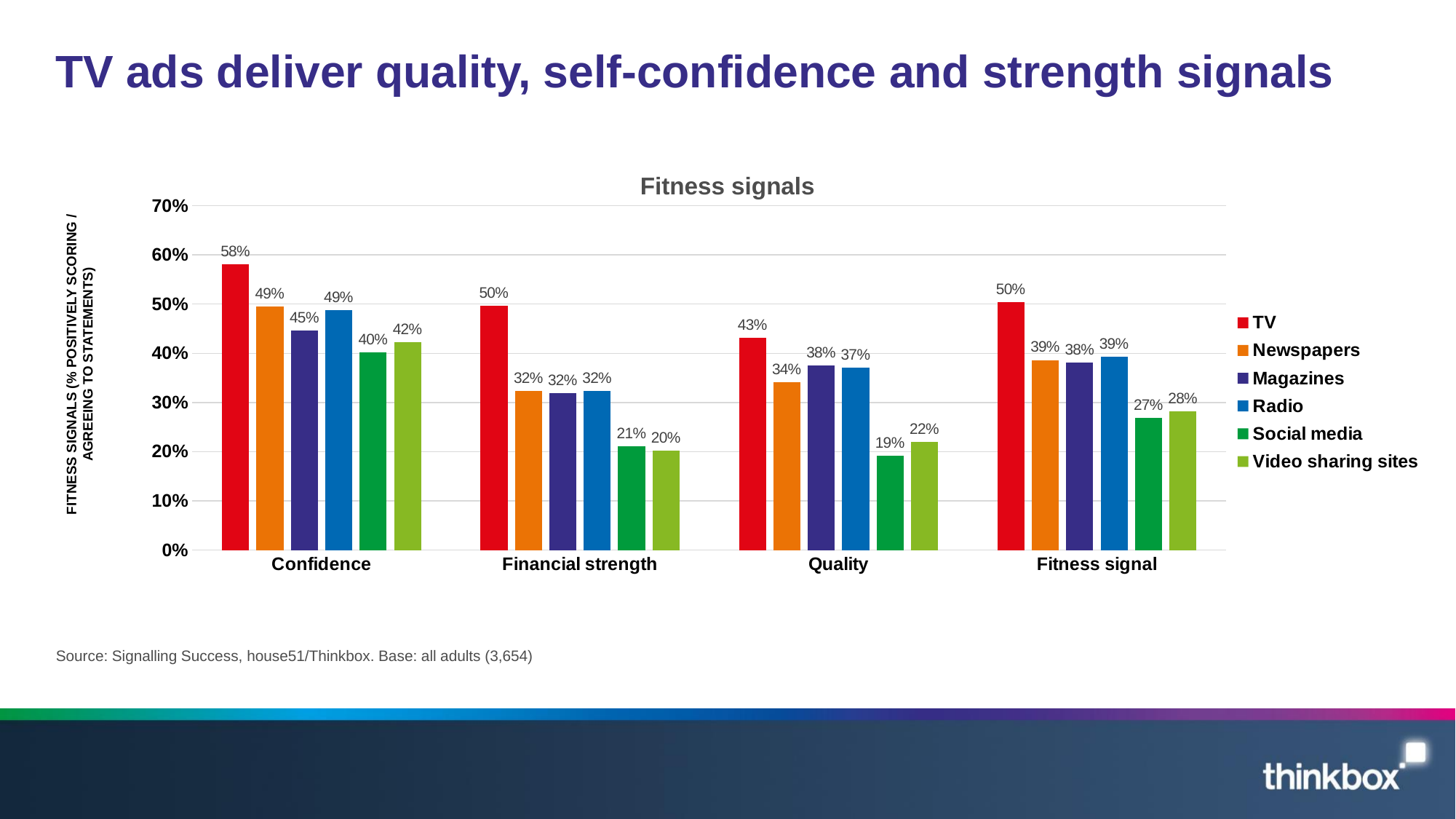
Which series has the lowest value in the Financial strength category? Video sharing sites How many series does the legend list? 6 How many categories are shown on the x axis? 4 What kind of chart is shown on the slide? Bar chart What is the value for Video sharing sites in the Fitness signal category? 28% What is the difference between the TV and Newspapers values in the Confidence category? 9% Which series has the highest value in the Quality category? TV Which is larger in the Fitness signal category: Newspapers or Social media? Newspapers What is the value for Social media in the Financial strength category? 21% What is the value for TV in the Confidence category? 58% What is the title of the chart? Fitness signals What is the value for Radio in the Quality category? 37%